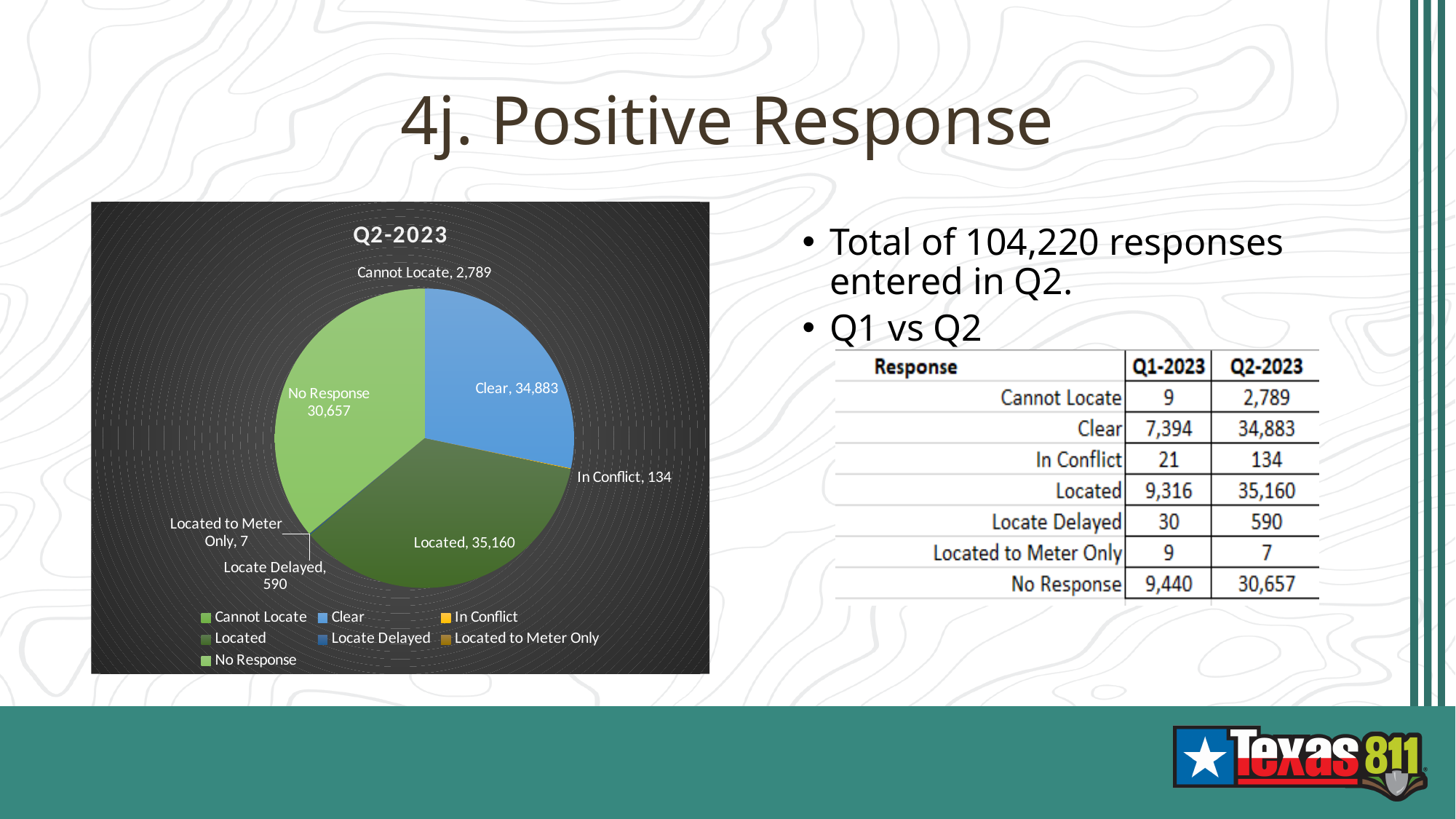
What kind of chart is shown on the slide? Pie chart How many categories are shown in the Q2-2023 pie chart? 7 What is the difference between the Located and Clear values in the Q2-2023 pie chart? 277 In the Q2-2023 pie chart, which is larger: Clear or No Response? Clear Which category has the largest slice in the Q2-2023 pie chart? Located Which category has the smallest slice in the Q2-2023 pie chart? Located to Meter Only What is the title of the chart on the slide? Q2-2023 What is the value for Locate Delayed in the Q2-2023 pie chart? 590 What is the value for No Response in the Q2-2023 pie chart? 30,657 What is the value for In Conflict in the Q2-2023 pie chart? 134 What is the difference between the Cannot Locate and Locate Delayed values in the Q2-2023 pie chart? 2,199 What is the value for Clear in the Q2-2023 pie chart? 34,883